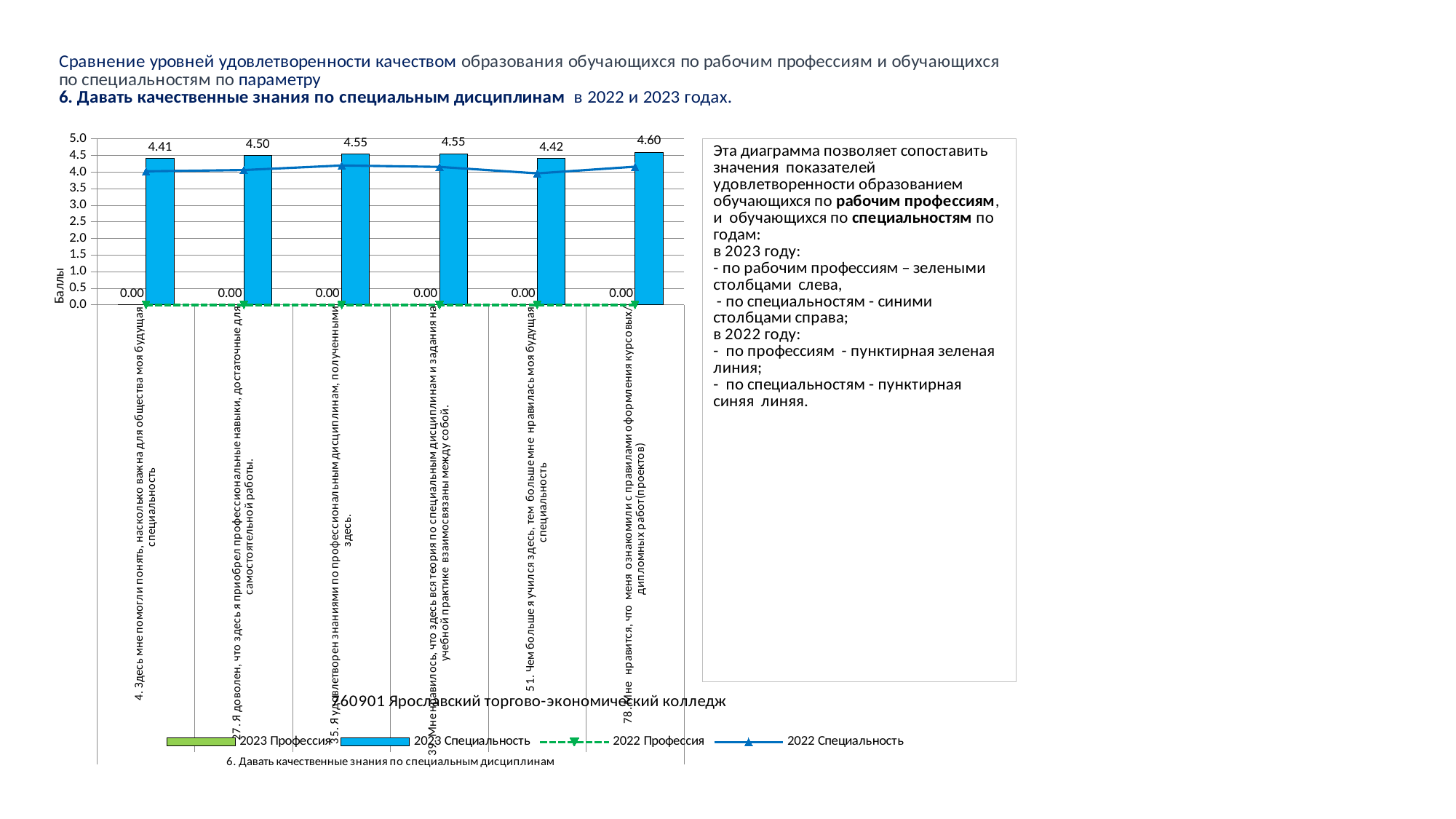
What is the 2023 Специальность value for item 78 (Мне нравится, что меня ознакомили с правилами оформления курсовых, дипломных работ)? 4.60 How many series does the legend list? 4 What is the 2023 Специальность value for item 4 (Здесь мне помогли понять, насколько важна для общества моя будущая специальность)? 4.41 Is the 2022 Специальность value for item 35 greater or less than 3.5? greater How many items (categories) are plotted on the x axis? 6 Which item has the highest 2023 Специальность value? 78. Мне нравится, что меня ознакомили с правилами оформления курсовых, дипломных работ (проектов) Which item has the lowest 2023 Специальность value? 4. Здесь мне помогли понять, насколько важна для общества моя будущая специальность What is the difference between the highest and lowest 2023 Специальность values (item 78 and item 4)? 0.19 What is the 2023 Специальность value for item 51 (Чем больше я учился здесь, тем больше мне нравилась моя будущая специальность)? 4.42 What is the label of the vertical axis? Баллы